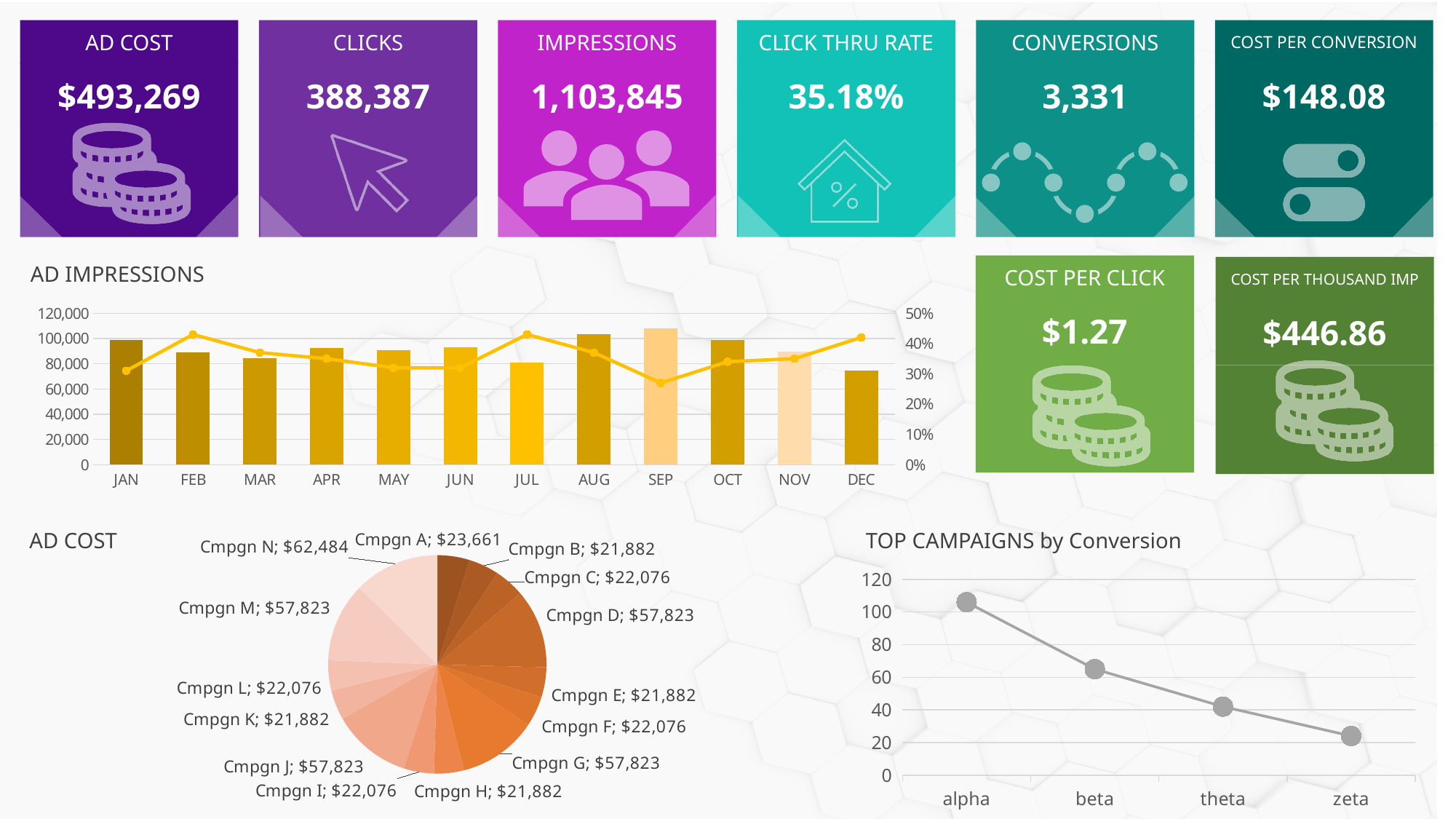
In the AD IMPRESSIONS chart, which month has the tallest bar? SEP What kind of chart is the AD COST chart? pie chart In the AD COST pie chart, what is the value for Cmpgn D? $57,823 In the AD COST pie chart, how many campaigns are shown? 14 In the AD IMPRESSIONS chart, is the bar for JAN greater or less than 80,000? greater In the AD IMPRESSIONS chart, is the bar for DEC greater or less than 80,000? less In the AD COST pie chart, what is the difference between Cmpgn N and Cmpgn A? $38,823 In the AD IMPRESSIONS chart, how many months are shown on the x axis? 12 In the AD IMPRESSIONS chart, which month has the shortest bar? DEC In the TOP CAMPAIGNS by Conversion chart, is the value for zeta greater or less than 40? less In the TOP CAMPAIGNS by Conversion chart, do the values rise or fall from alpha to zeta? fall In the AD COST pie chart, which campaign has the largest value? Cmpgn N